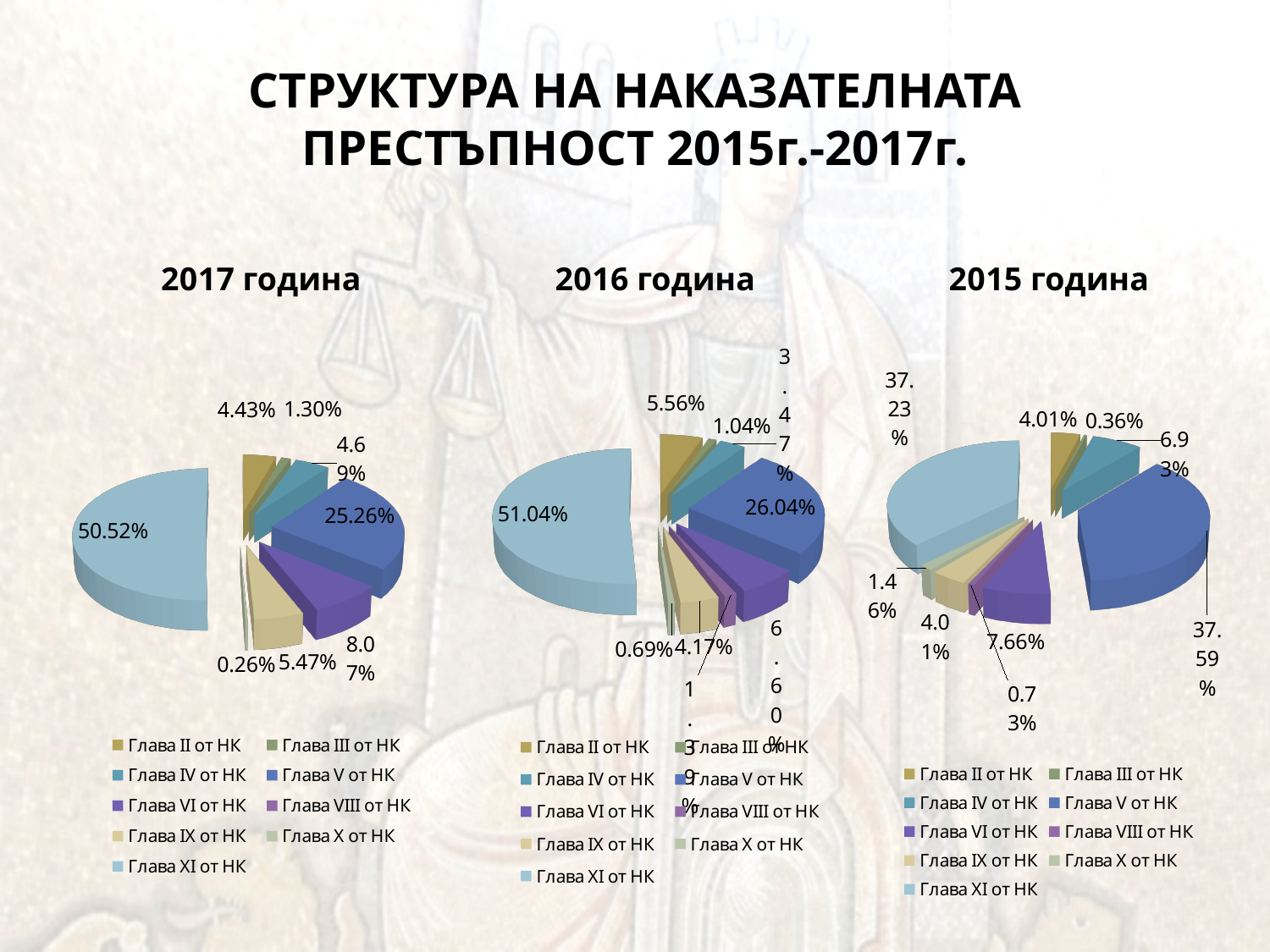
In the 2015 година pie chart, which is larger, the share of Глава V от НК or the share of Глава XI от НК? Глава V от НК In the 2017 година pie chart, what share is shown for Глава V от НК? 25.26% In the 2015 година pie chart, what share is shown for Глава V от НК? 37.59% In the 2017 година pie chart, what is the difference between the shares of Глава XI от НК and Глава V от НК? 25.26% In the 2016 година pie chart, what is the difference between the shares of Глава XI от НК and Глава V от НК? 25.00% What kind of chart is the 2017 година chart? Pie chart In the 2017 година pie chart, what share is shown for Глава II от НК? 4.43% In the 2016 година pie chart, what share is shown for Глава V от НК? 26.04% In the 2016 година pie chart, which category has the largest slice? Глава XI от НК In the 2016 година pie chart, what share is shown for Глава II от НК? 5.56% In the 2017 година pie chart, what share is shown for Глава XI от НК? 50.52% How many entries does the legend of the 2015 година chart list? 9